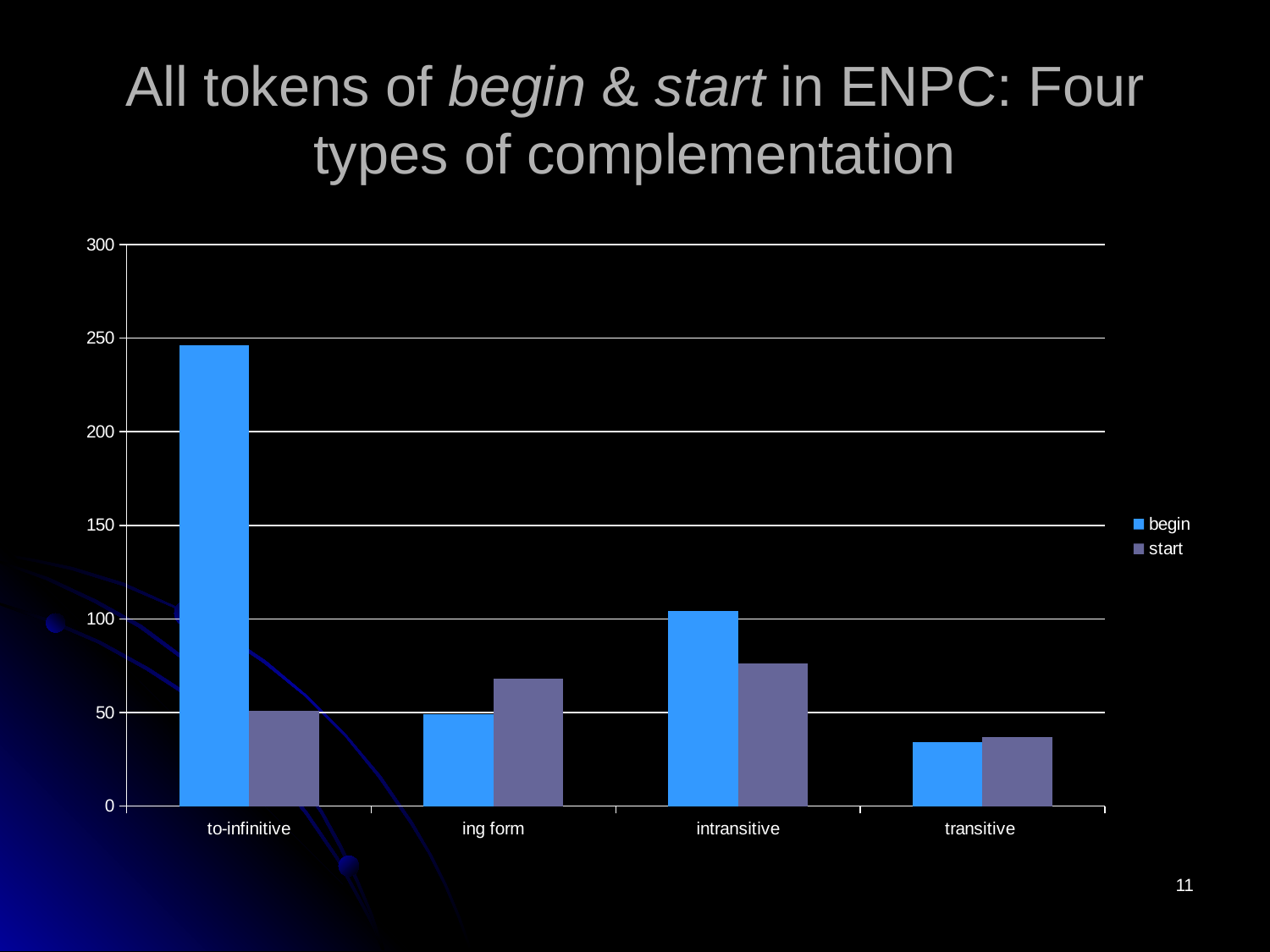
How many complementation types are shown on the x axis? 4 How many series does the legend list? 2 Which complementation type has the highest value for start? intransitive Is the value for begin with to-infinitive greater or less than 200? greater Is the value for begin with transitive greater or less than 50? less For the ing form, which is larger, begin or start? start Which complementation type has the lowest value for start? transitive Which complementation type has the highest value for begin? to-infinitive Which complementation type has the lowest value for begin? transitive Which series is shown in the lighter blue colour? begin Is the value for start with intransitive greater or less than 100? less What kind of chart is shown on the slide? bar chart